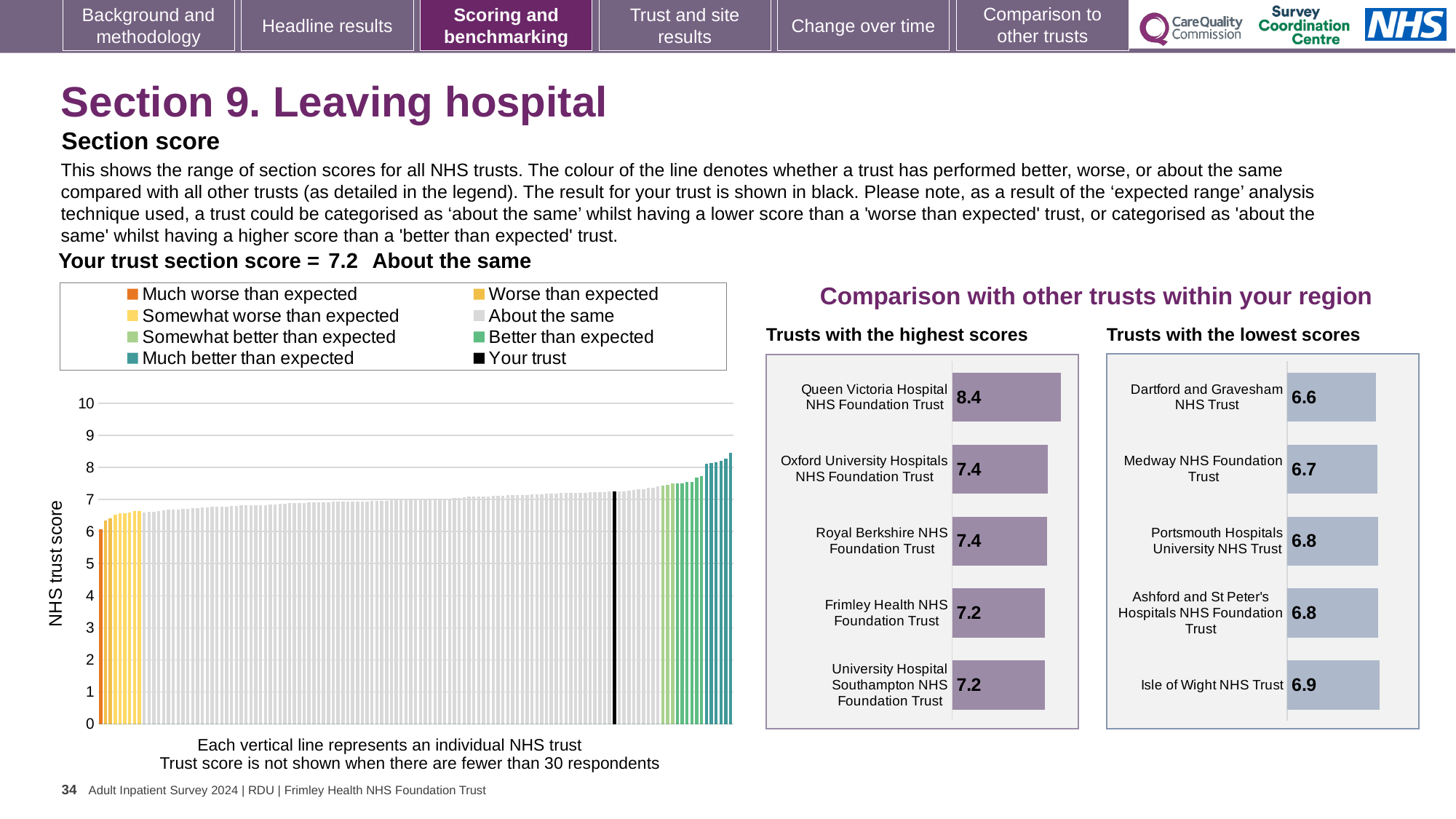
In the 'Trusts with the lowest scores' chart, which has the higher score: Medway NHS Foundation Trust or Isle of Wight NHS Trust? Isle of Wight NHS Trust In the 'Trusts with the lowest scores' chart, what is the score for Dartford and Gravesham NHS Trust? 6.6 What type of chart is the 'Trusts with the lowest scores' chart? Bar chart In the 'Trusts with the highest scores' chart, which trust has the highest score? Queen Victoria Hospital NHS Foundation Trust How many entries does the legend of the main NHS trust score chart on the left list? 8 In the 'Trusts with the lowest scores' chart, what is the difference between the scores of Isle of Wight NHS Trust and Dartford and Gravesham NHS Trust? 0.3 In the 'Trusts with the highest scores' chart, what is the score for Royal Berkshire NHS Foundation Trust? 7.4 In the 'Trusts with the lowest scores' chart, which trust has the lowest score? Dartford and Gravesham NHS Trust In the 'Trusts with the highest scores' chart, what is the difference between the scores of Queen Victoria Hospital NHS Foundation Trust and Oxford University Hospitals NHS Foundation Trust? 1.0 How many trusts are shown in the 'Trusts with the highest scores' chart? 5 In the 'Trusts with the highest scores' chart, what is the score for Queen Victoria Hospital NHS Foundation Trust? 8.4 How many trusts are shown in the 'Trusts with the lowest scores' chart? 5